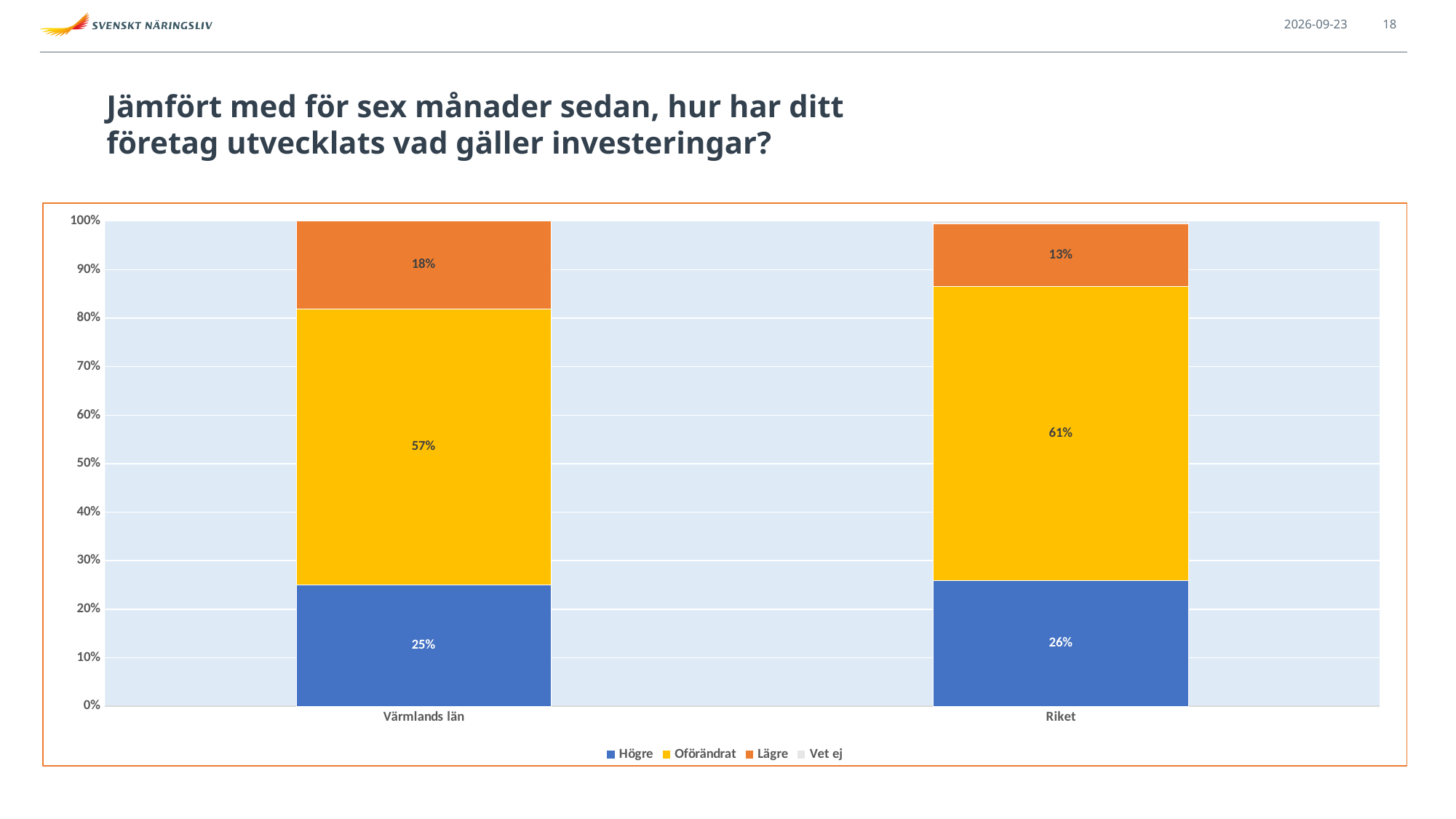
What share of Riket respondents answered Högre? 26% How many series does the legend list? 4 How many categories are shown on the x axis? 2 What type of chart is shown on the slide? Stacked bar chart What is the value of the Lägre segment for Riket? 13% Which category has the larger Högre share, Värmlands län or Riket? Riket How many percentage points higher is the Oförändrat share for Riket than for Värmlands län? 4 percentage points Which response has the largest share in the Värmlands län bar? Oförändrat What is the Högre value for Värmlands län? 25% What is the difference between the Lägre share for Värmlands län and for Riket? 5 percentage points Which category has the larger Lägre share, Värmlands län or Riket? Värmlands län What percentage of respondents in Värmlands län answered Oförändrat? 57%